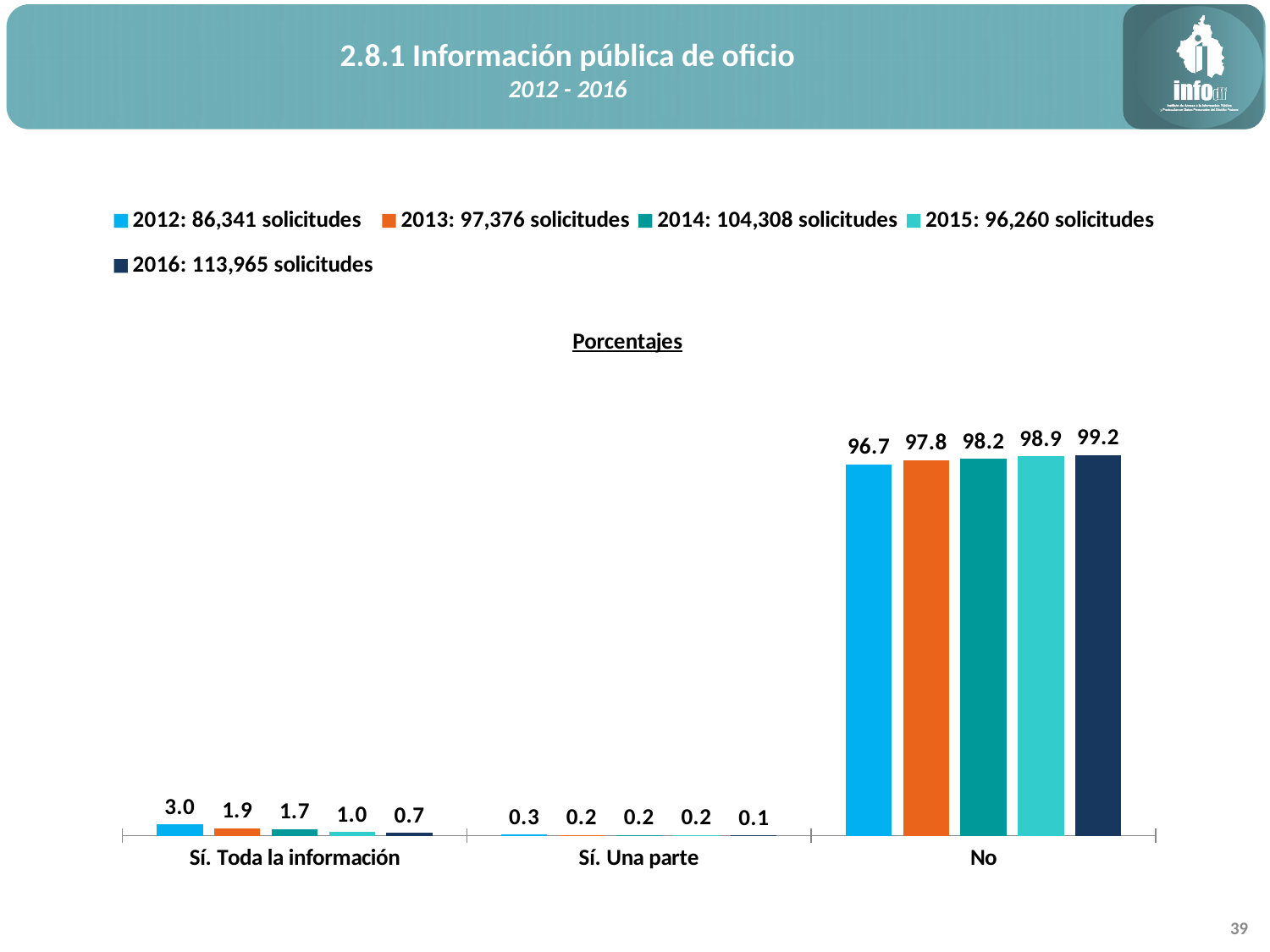
How many categories are shown on the x axis? 3 What is the difference between the 2016 and 2012 values in the 'No' category? 2.5 What is the value for 2012 in the 'No' category? 96.7 Do the values for the 'No' category rise or fall from 2012 to 2016? Rise How many series does the legend list? 5 Which year has the lowest value in the 'Sí. Toda la información' category? 2016 What is the value for 2014 in the 'Sí. Una parte' category? 0.2 Which is larger in the 'Sí. Toda la información' category: the value for 2012 or the value for 2013? 2012 Which year has the highest value in the 'No' category? 2016 What is the value for 2016 in the 'Sí. Toda la información' category? 0.7 According to the legend, how many solicitudes were there in 2014? 104,308 solicitudes What kind of chart is shown on the slide? Bar chart